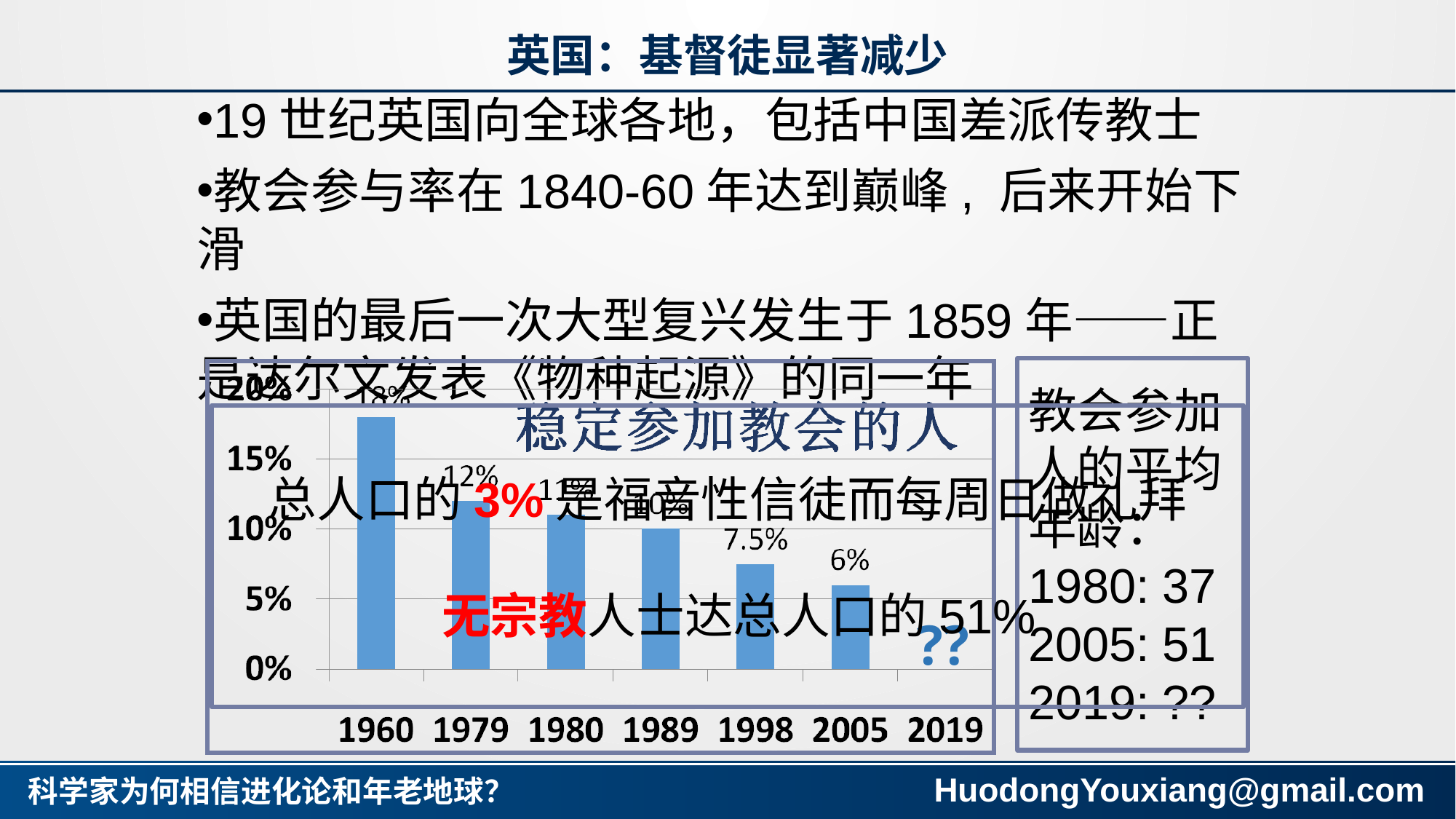
Is the value for 1989 greater or less than 5%? greater Which year with a plotted bar has the lowest value? 2005 How many years are labelled on the x axis? 7 What is the value for 1998? 7.5% What is the value for 1960? 18% Which is larger, the value for 1979 or the value for 1998? 1979 What is the value for 2005? 6% Do the values rise or fall from 1960 to 2005? fall What is the value for 1979? 12% Which year has the highest bar? 1960 What type of chart is shown on the slide? bar chart What is the difference between the values for 1998 and 2005? 1.5%